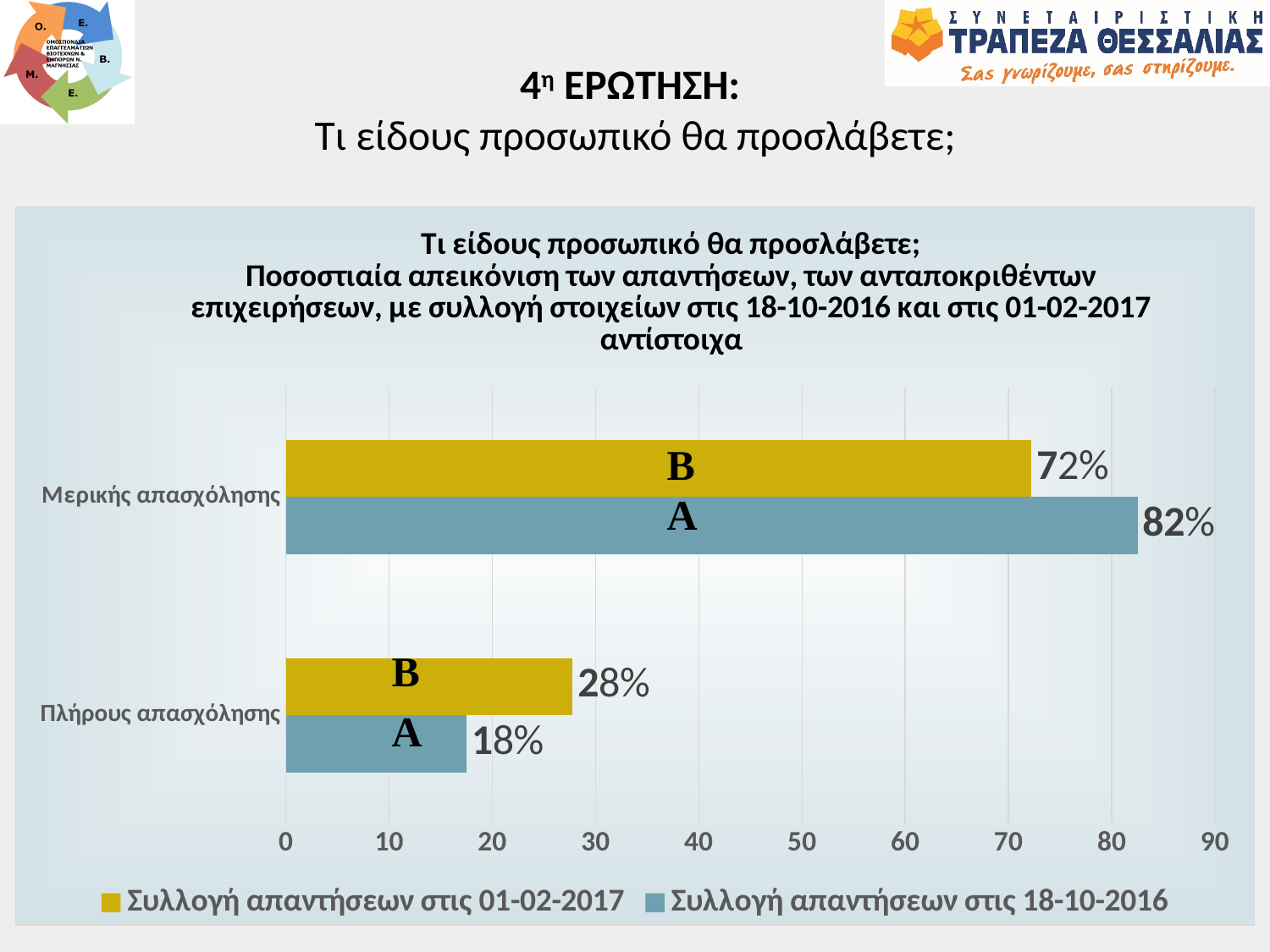
What is the value for Πλήρους απασχόλησης in the series Συλλογή απαντήσεων στις 01-02-2017? 28% Which category has the highest value in the series Συλλογή απαντήσεων στις 18-10-2016? Μερικής απασχόλησης Which category has the lowest value in the series Συλλογή απαντήσεων στις 01-02-2017? Πλήρους απασχόλησης How many series does the legend list? 2 How many categories are shown on the chart? 2 What is the value for Μερικής απασχόλησης in the series Συλλογή απαντήσεων στις 01-02-2017? 72% What is the difference between the two series' values for Πλήρους απασχόλησης? 10% For Πλήρους απασχόλησης, which series has the larger value? Συλλογή απαντήσεων στις 01-02-2017 What is the value for Πλήρους απασχόλησης in the series Συλλογή απαντήσεων στις 18-10-2016? 18% What is the difference between the two series' values for Μερικής απασχόλησης? 10% What kind of chart is shown on the slide? Bar chart What is the value for Μερικής απασχόλησης in the series Συλλογή απαντήσεων στις 18-10-2016? 82%